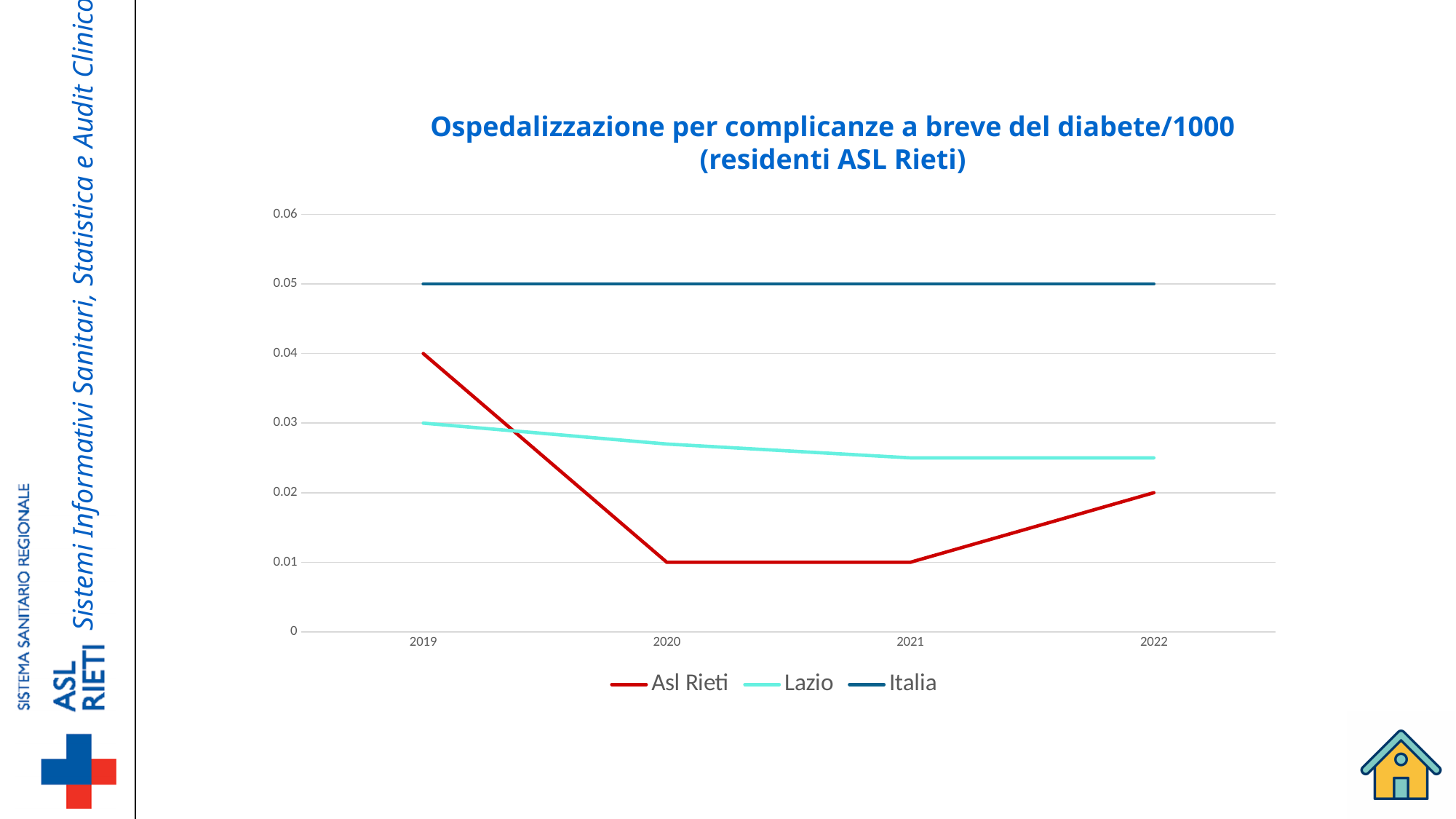
What is the value for Asl Rieti in 2019? 0.04 What is the value for Lazio in 2019? 0.03 Which series has the lowest value in 2021? Asl Rieti What is the value for Asl Rieti in 2020? 0.01 Which series has the highest value in 2019? Italia Is the value for Lazio in 2022 greater or less than 0.03? less What type of chart is shown on the slide? Line chart What is the value for Italia in 2021? 0.05 How many series does the legend list? 3 What is the difference between the Asl Rieti value in 2019 and in 2022? 0.02 How many years are shown on the x axis? 4 Does the Asl Rieti line rise or fall from 2019 to 2020? Fall